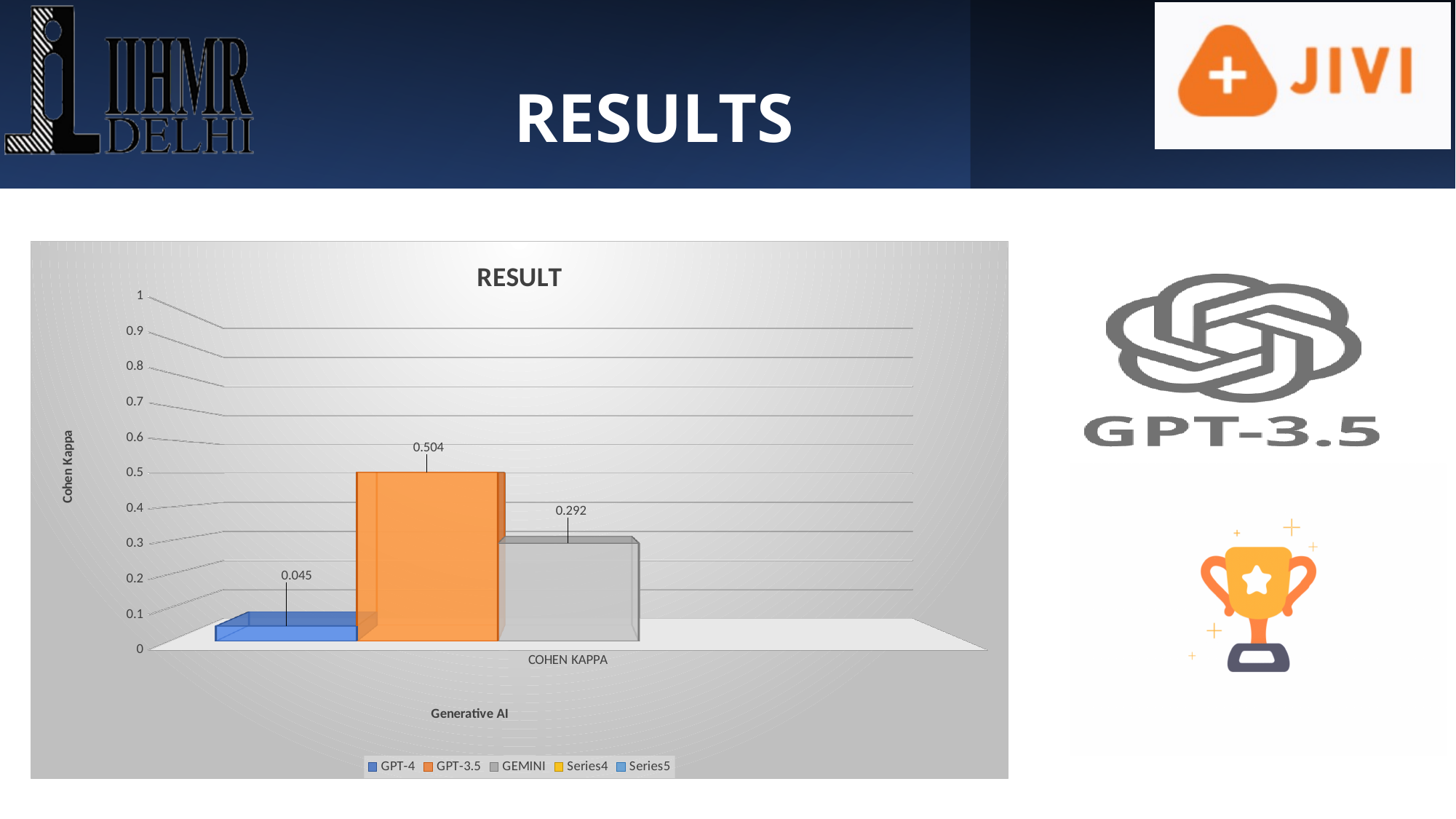
What is the Cohen Kappa value for GEMINI? 0.292 What is the difference between the Cohen Kappa values of GPT-3.5 and GEMINI? 0.212 Which series has the highest Cohen Kappa value? GPT-3.5 What is the Cohen Kappa value for GPT-4? 0.045 What is the Cohen Kappa value for GPT-3.5? 0.504 What kind of chart is shown on the slide? Bar chart Which series has the lowest Cohen Kappa value? GPT-4 Is the Cohen Kappa value for GPT-3.5 greater or less than 0.5? greater Which has a larger Cohen Kappa value, GEMINI or GPT-4? GEMINI What is the difference between the Cohen Kappa values of GEMINI and GPT-4? 0.247 How many series does the legend list? 5 What is the title of the chart? RESULT